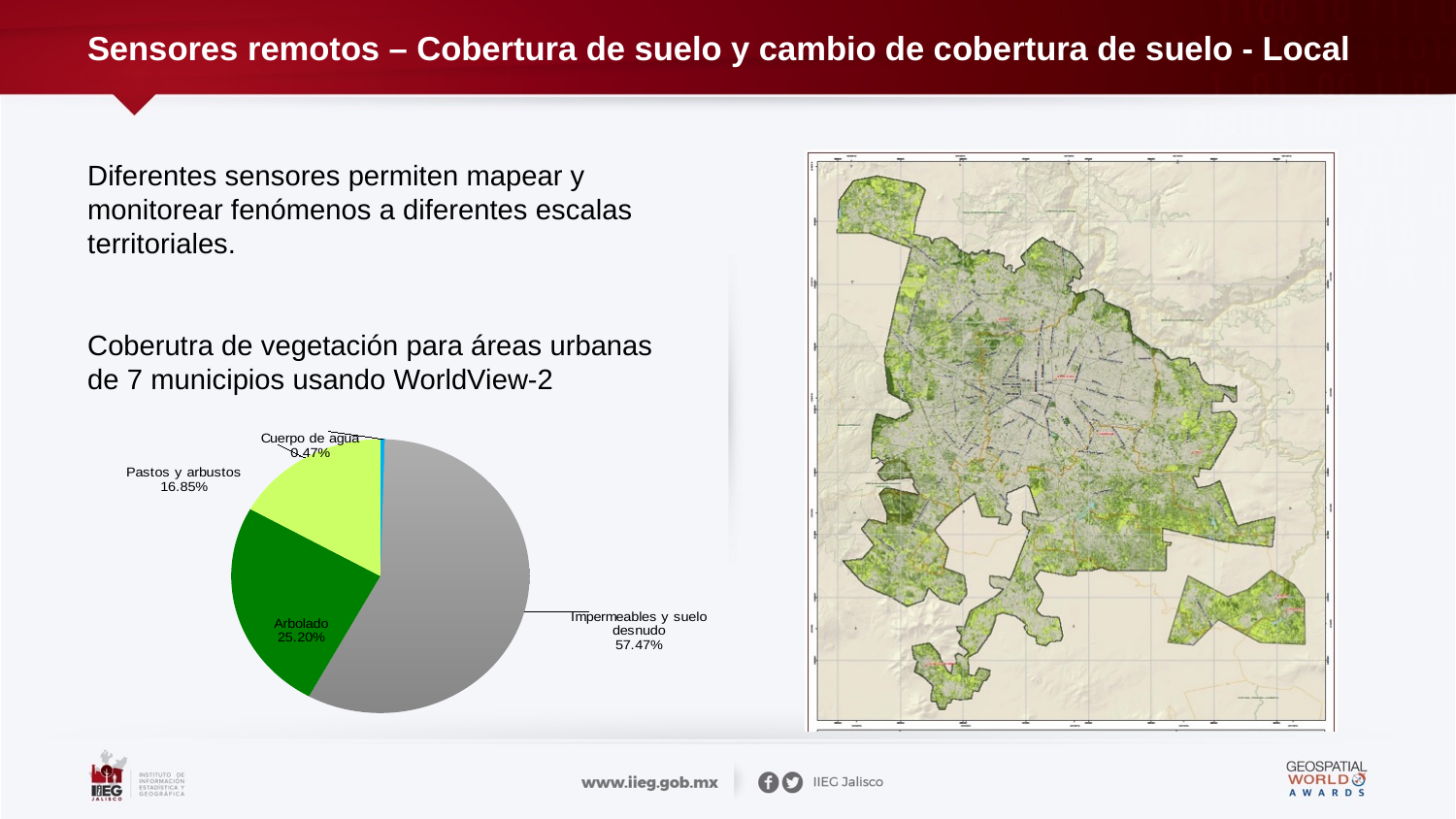
What is the difference in percentage points between Arbolado and Pastos y arbustos? 8.35 What colour is the Arbolado slice in the pie chart? green What percentage does the pie chart show for Impermeables y suelo desnudo? 57.47% What percentage does the pie chart show for Cuerpo de agua? 0.47% Which is larger in the pie chart, Arbolado or Pastos y arbustos? Arbolado How many slices does the pie chart have? 4 What percentage does the pie chart show for Arbolado? 25.20% What kind of chart is shown on the slide? pie chart What percentage does the pie chart show for Pastos y arbustos? 16.85% Which category has the largest share of the pie chart? Impermeables y suelo desnudo What is the difference in percentage points between Impermeables y suelo desnudo and Arbolado? 32.27 Which category has the smallest share of the pie chart? Cuerpo de agua